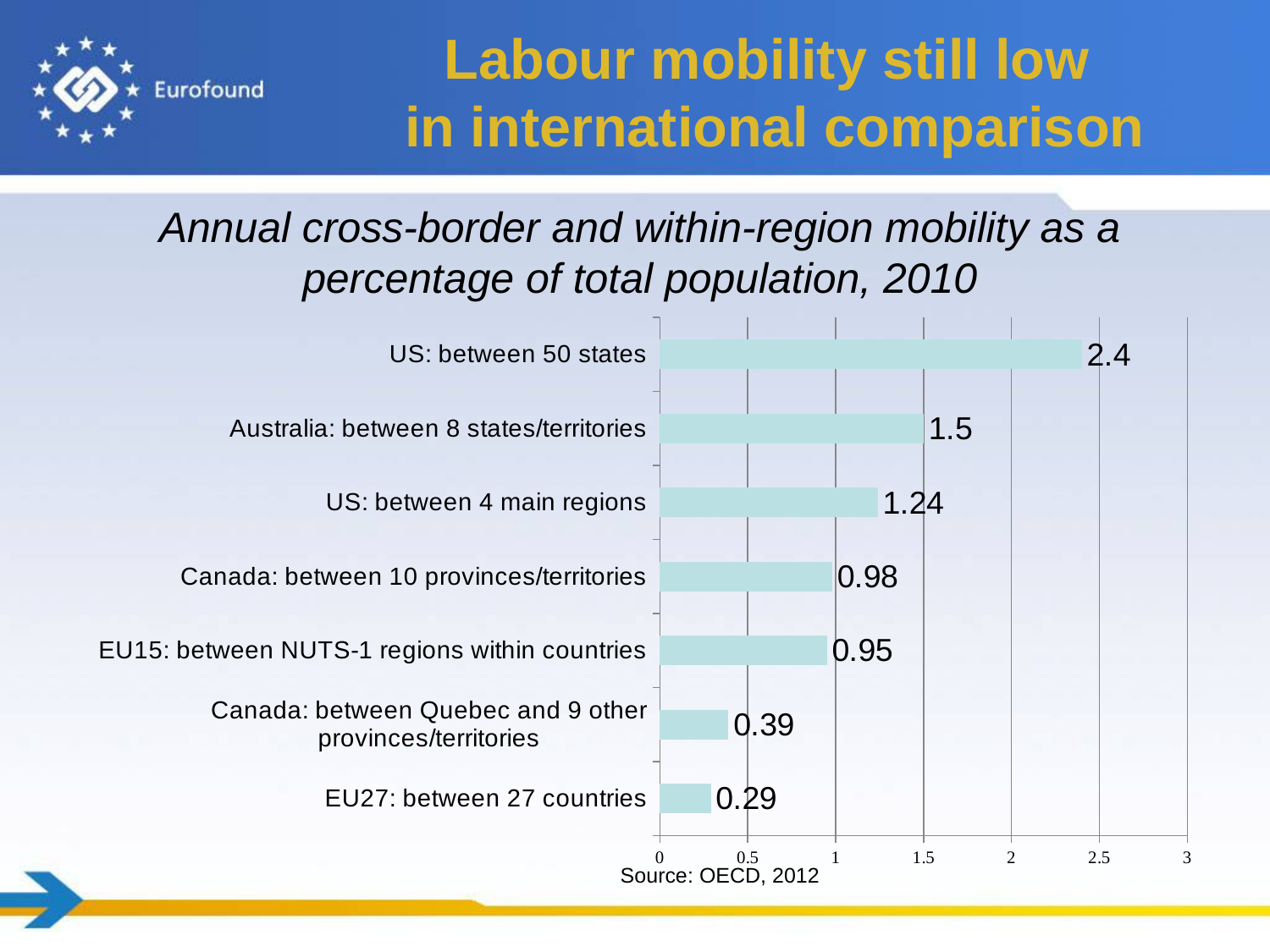
What kind of chart is shown on the slide? bar chart Which category has the highest value? US: between 50 states What is the value for EU27: between 27 countries? 0.29 How many categories are shown in the chart? 7 Which is larger, the value for Australia: between 8 states/territories or the value for US: between 4 main regions? Australia: between 8 states/territories What source is cited below the chart? OECD, 2012 What is the value for Canada: between 10 provinces/territories? 0.98 Which category has the lowest value? EU27: between 27 countries What is the difference between the values for Canada: between Quebec and 9 other provinces/territories and EU27: between 27 countries? 0.1 What is the value for US: between 50 states? 2.4 What is the difference between the values for US: between 50 states and Australia: between 8 states/territories? 0.9 Is the value for EU15: between NUTS-1 regions within countries greater or less than 1? less